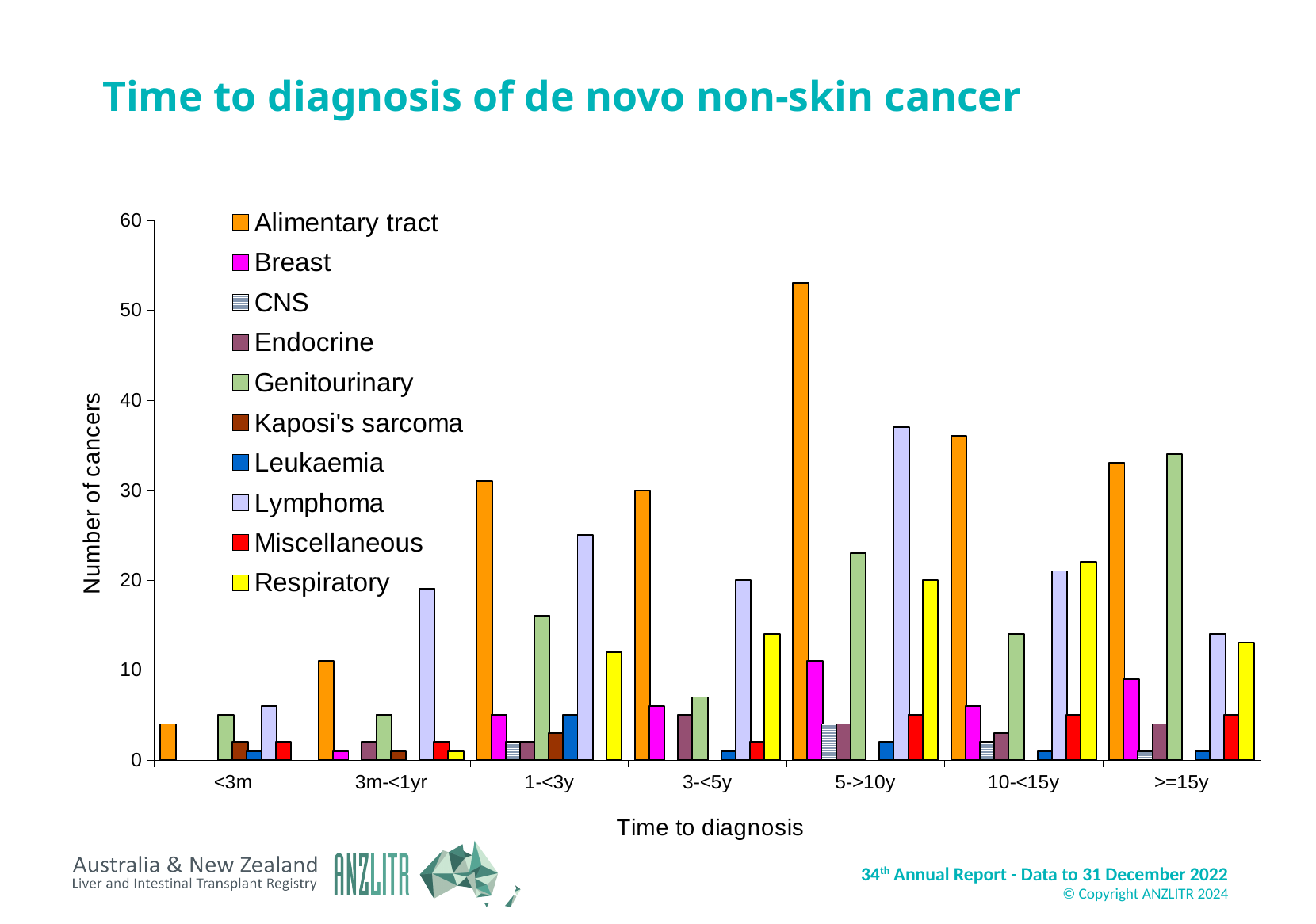
In the >=15y category, which is larger: Genitourinary or Alimentary tract? Genitourinary In which time-to-diagnosis category is the Alimentary tract bar highest? 5->10y What is the label of the y axis? Number of cancers Is the value for Alimentary tract in the 5->10y category greater or less than 50? greater What is the title of the chart? Time to diagnosis of de novo non-skin cancer What kind of chart is shown on the slide? bar chart How many series does the legend list? 10 How many time-to-diagnosis categories are shown on the x axis? 7 Is the value for Alimentary tract in the 3m-<1yr category greater or less than 20? less Is the value for Lymphoma in the 5->10y category greater or less than 30? greater In the 1-<3y category, which is larger: Alimentary tract or Lymphoma? Alimentary tract